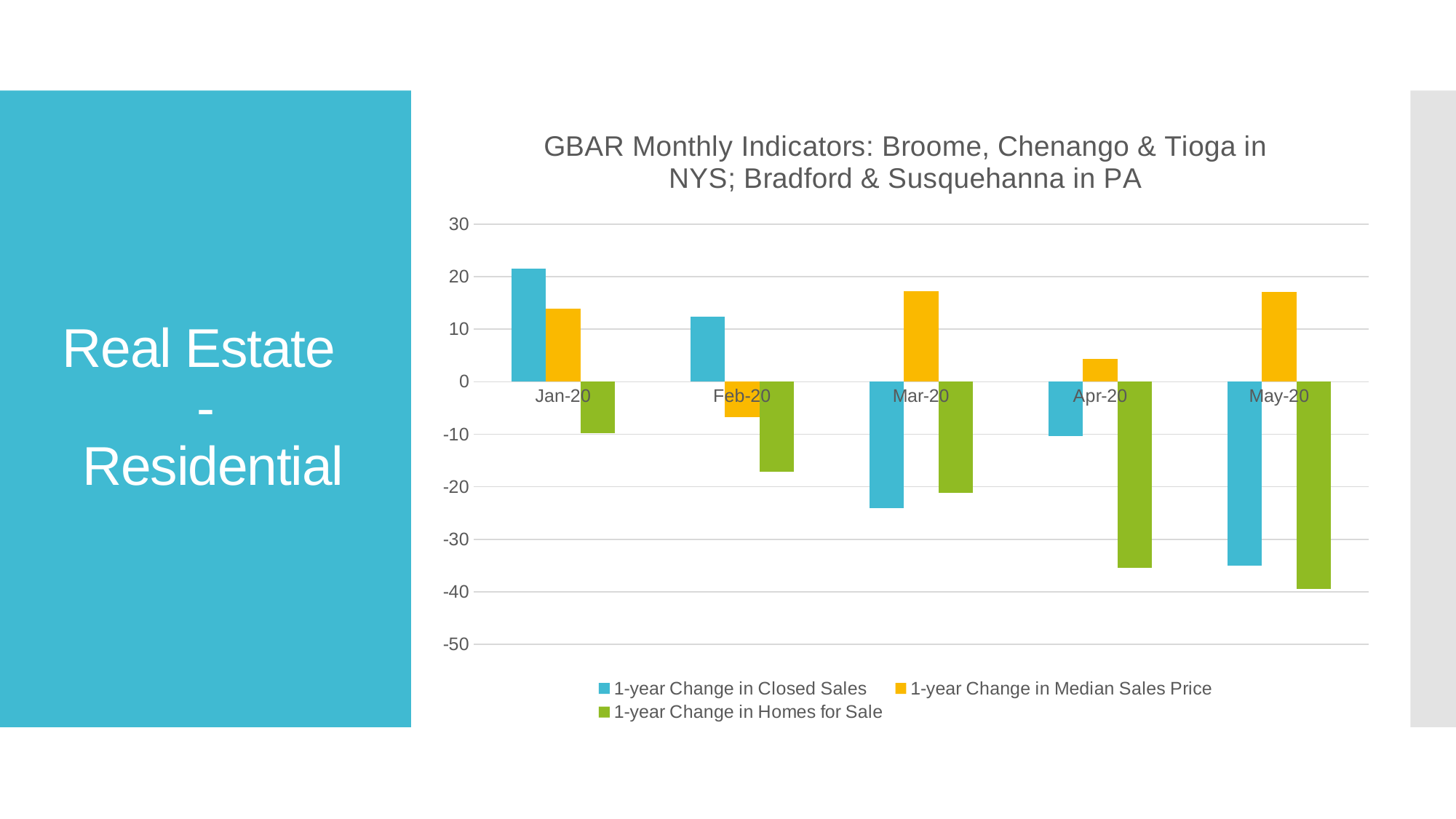
Which is larger, the 1-year Change in Median Sales Price in Mar-20 or in Apr-20? Mar-20 Which month has the lowest value for 1-year Change in Closed Sales? May-20 What kind of chart is shown on the slide? Bar chart Which month has the lowest value for 1-year Change in Homes for Sale? May-20 Does the 1-year Change in Homes for Sale rise or fall from Jan-20 to May-20? Fall Is the value for 1-year Change in Homes for Sale in May-20 greater or less than -30? less Which month has the highest value for 1-year Change in Closed Sales? Jan-20 How many months are shown on the x axis of the chart? 5 Is the value for 1-year Change in Closed Sales in Mar-20 greater or less than -20? less What colour represents the 1-year Change in Median Sales Price series in the chart? Yellow How many series does the chart's legend list? 3 Is the value for 1-year Change in Median Sales Price in Jan-20 greater or less than 10? greater